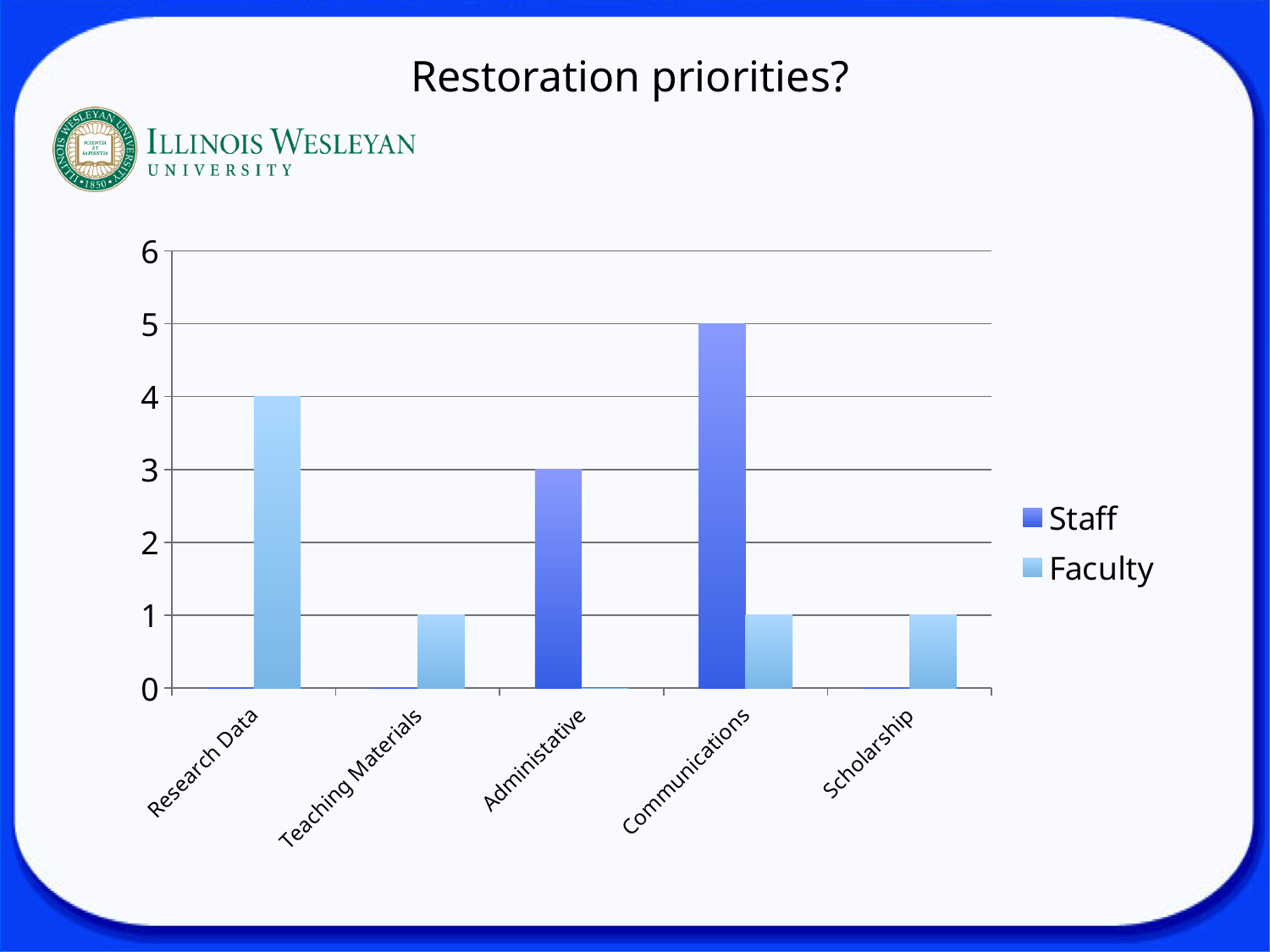
What is the difference between the Staff and Faculty values for Communications? 4 What is the Faculty value for Research Data? 4 How many series does the legend list? 2 Which is larger: the Faculty value for Research Data or the Staff value for Administative? Faculty value for Research Data What is the Staff value for Communications? 5 What is the title of the chart? Restoration priorities? Which category has the highest Faculty value? Research Data What is the Staff value for Administative? 3 What is the Faculty value for Scholarship? 1 How many categories are shown on the x axis? 5 Which category has the highest Staff value? Communications What type of chart is shown on the slide? bar chart